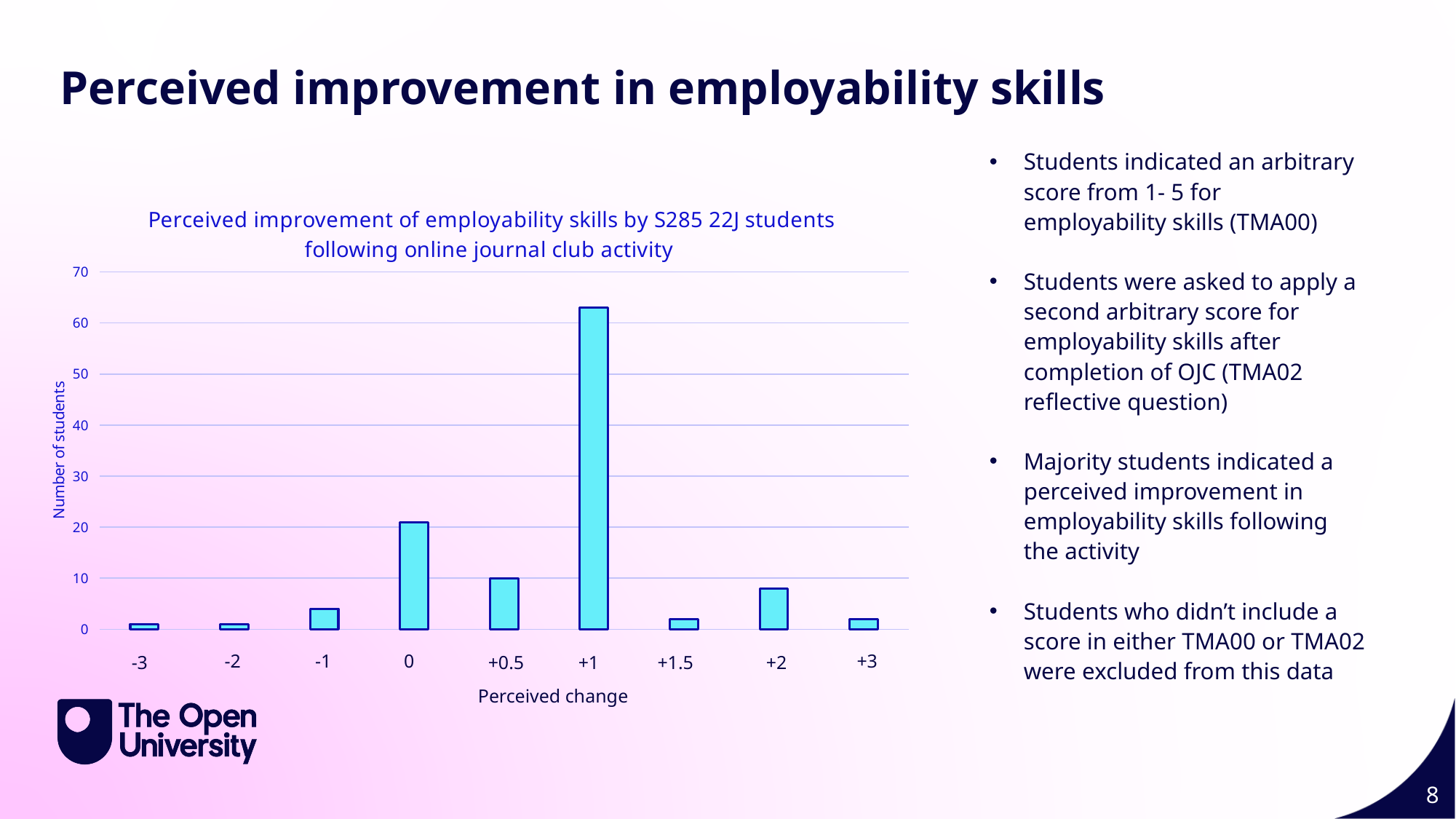
What is the label of the x axis of the chart? Perceived change Is the number of students for perceived change -1 greater or less than 10? less Is the number of students for perceived change +1.5 greater or less than 10? less What is the label of the y axis of the chart? Number of students Which perceived change category has the highest number of students? +1 Which has more students: perceived change 0 or perceived change +2? 0 Is the number of students for perceived change +1 greater or less than 60? greater What kind of chart is shown on the slide? bar chart Which has more students: perceived change +0.5 or perceived change -1? +0.5 How many perceived change categories are shown on the x axis? 9